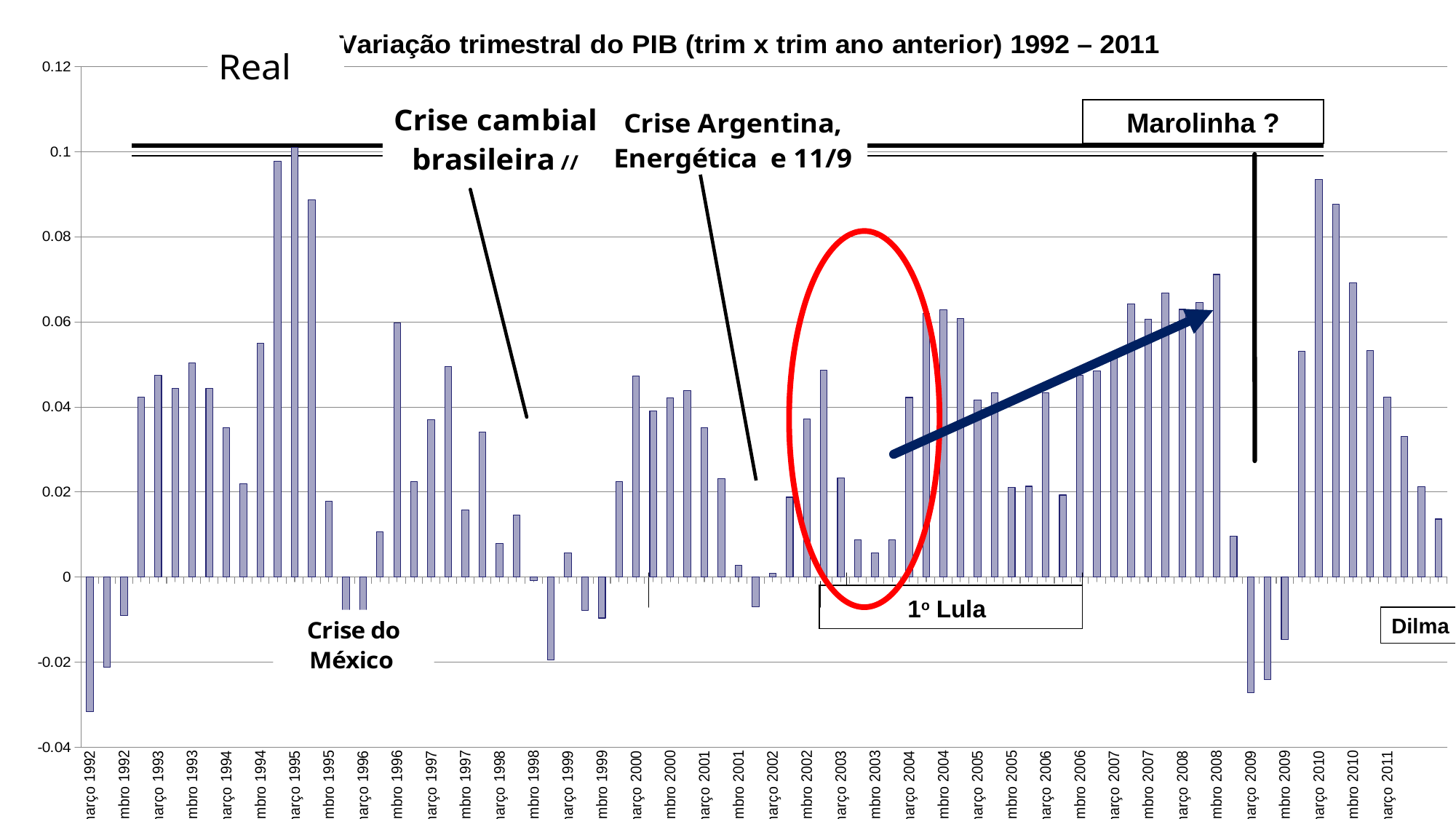
Is the value for março 1992 greater or less than -0.02? less Is the value for março 1993 greater or less than 0.04? greater Which is larger, the value for março 2010 or the value for março 2011? março 2010 Is the value for março 2009 greater or less than -0.02? less What kind of chart is shown on the slide? bar chart What is the title of the chart? Variação trimestral do PIB (trim x trim ano anterior) 1992 – 2011 What is the highest value shown on the vertical axis? 0.12